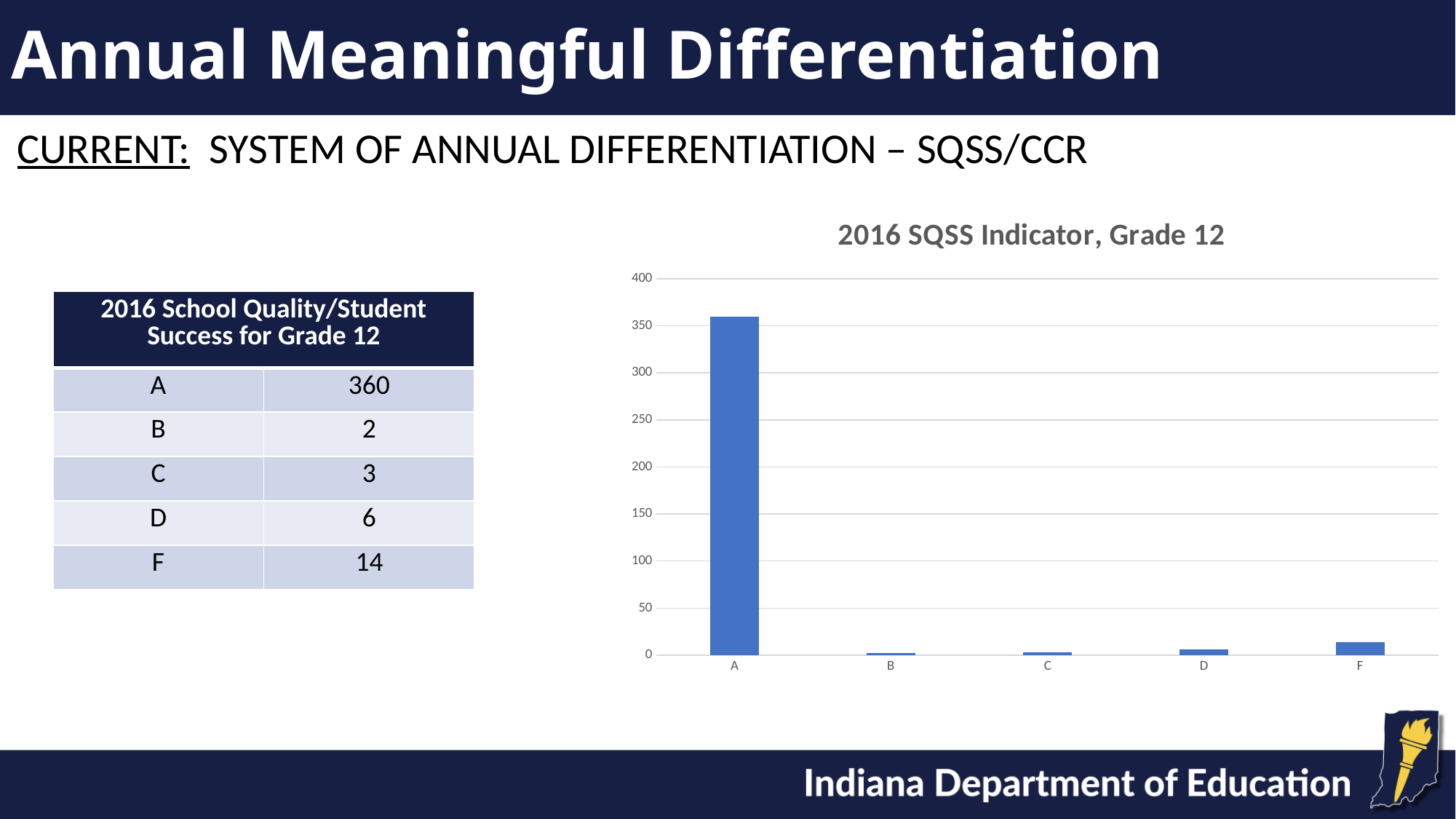
What is the value for F in the 2016 SQSS Indicator, Grade 12 chart, as printed in the table on the slide? 14 Which category has the highest bar in the chart? A What is the title of the chart? 2016 SQSS Indicator, Grade 12 Is the value for F in the chart greater or less than 50? less Which is larger in the chart, the value for D or the value for F? F What is the value for A in the 2016 SQSS Indicator, Grade 12 chart, as printed in the table on the slide? 360 What type of chart is shown on the slide? bar chart Which category has the lowest bar in the chart? B How many categories are plotted on the x axis of the chart? 5 Is the value for A in the chart greater or less than 350? greater Which is larger in the chart, the value for A or the value for C? A Using the values printed in the table, what is the difference between the value for A and the value for F? 346